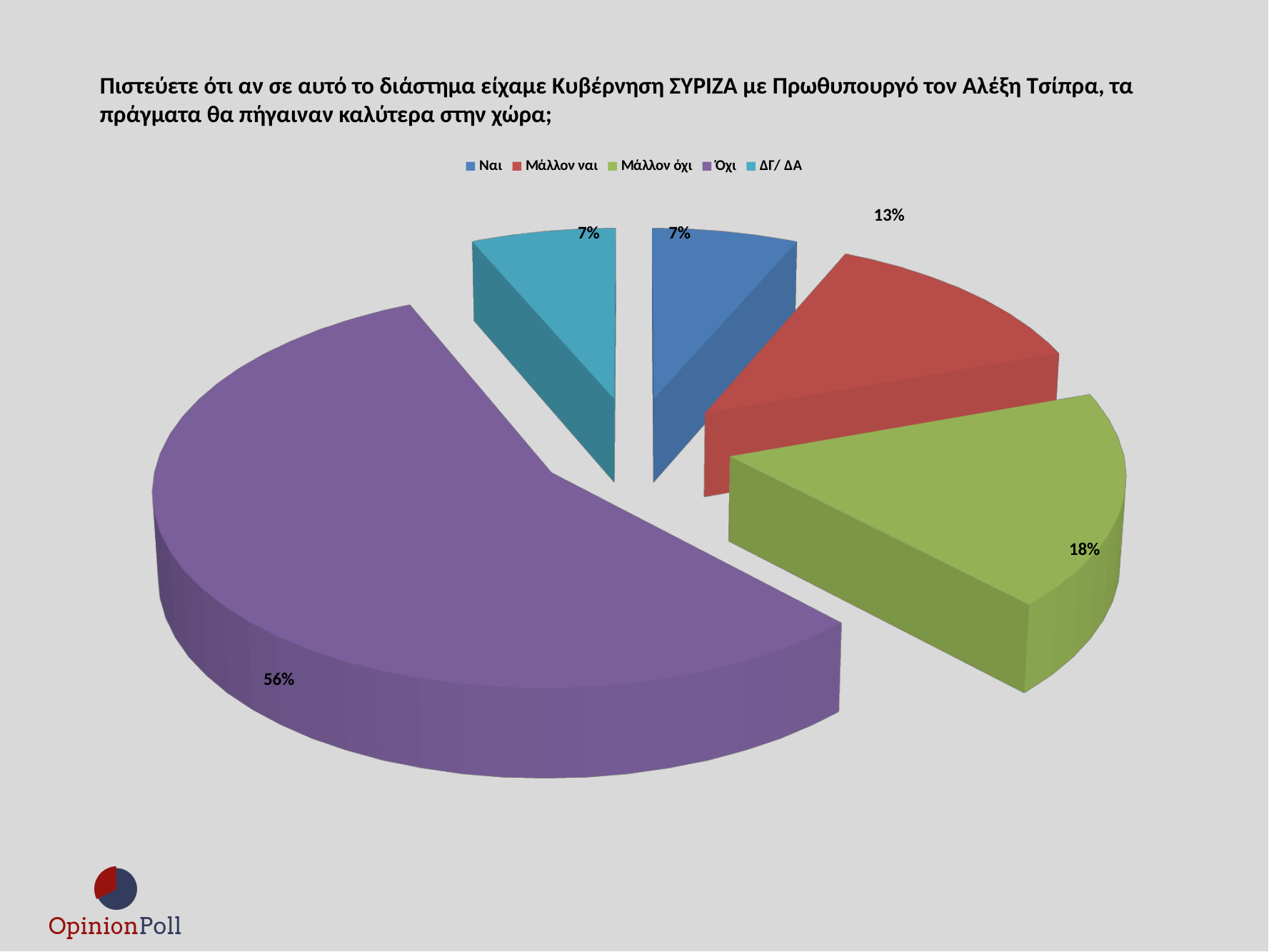
What percentage of respondents answered Όχι? 56% What percentage of respondents answered ΔΓ/ ΔΑ? 7% What percentage of respondents answered Μάλλον όχι? 18% Which is larger, the share for Μάλλον ναι or the share for Μάλλον όχι? Μάλλον όχι What is the combined share of Ναι and Μάλλον ναι? 20% How many categories does the legend list? 5 What percentage of respondents answered Μάλλον ναι? 13% What kind of chart is shown on the slide? Pie chart Which colour represents Όχι in the chart? Purple What percentage of respondents answered Ναι? 7% Which response has the largest share of the pie? Όχι What is the difference in percentage points between Όχι and Μάλλον όχι? 38